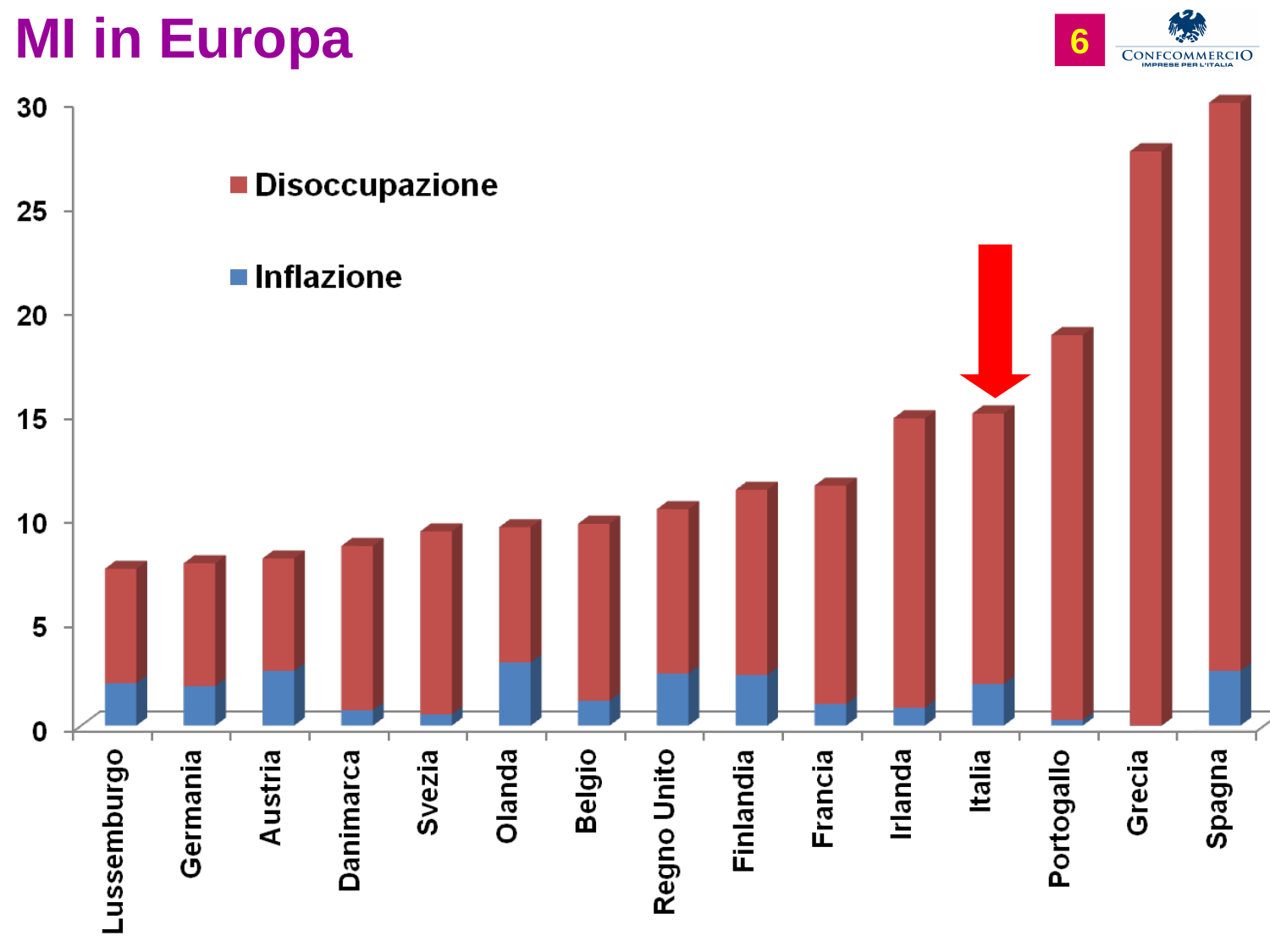
What kind of chart is shown on the slide? Stacked bar chart Do the total bar heights rise or fall from left to right along the x axis? Rise Which series is shown in red in the legend? Disoccupazione Which country has the highest total bar? Spagna Is the total value for Lussemburgo greater or less than 10? less Which country does the red arrow on the chart point to? Italia Is the total value for Grecia greater or less than 25? greater Is the total value for Italia greater or less than 20? less Which has the larger total bar, Grecia or Portogallo? Grecia How many series does the legend list? 2 How many countries are shown on the x axis of the chart? 15